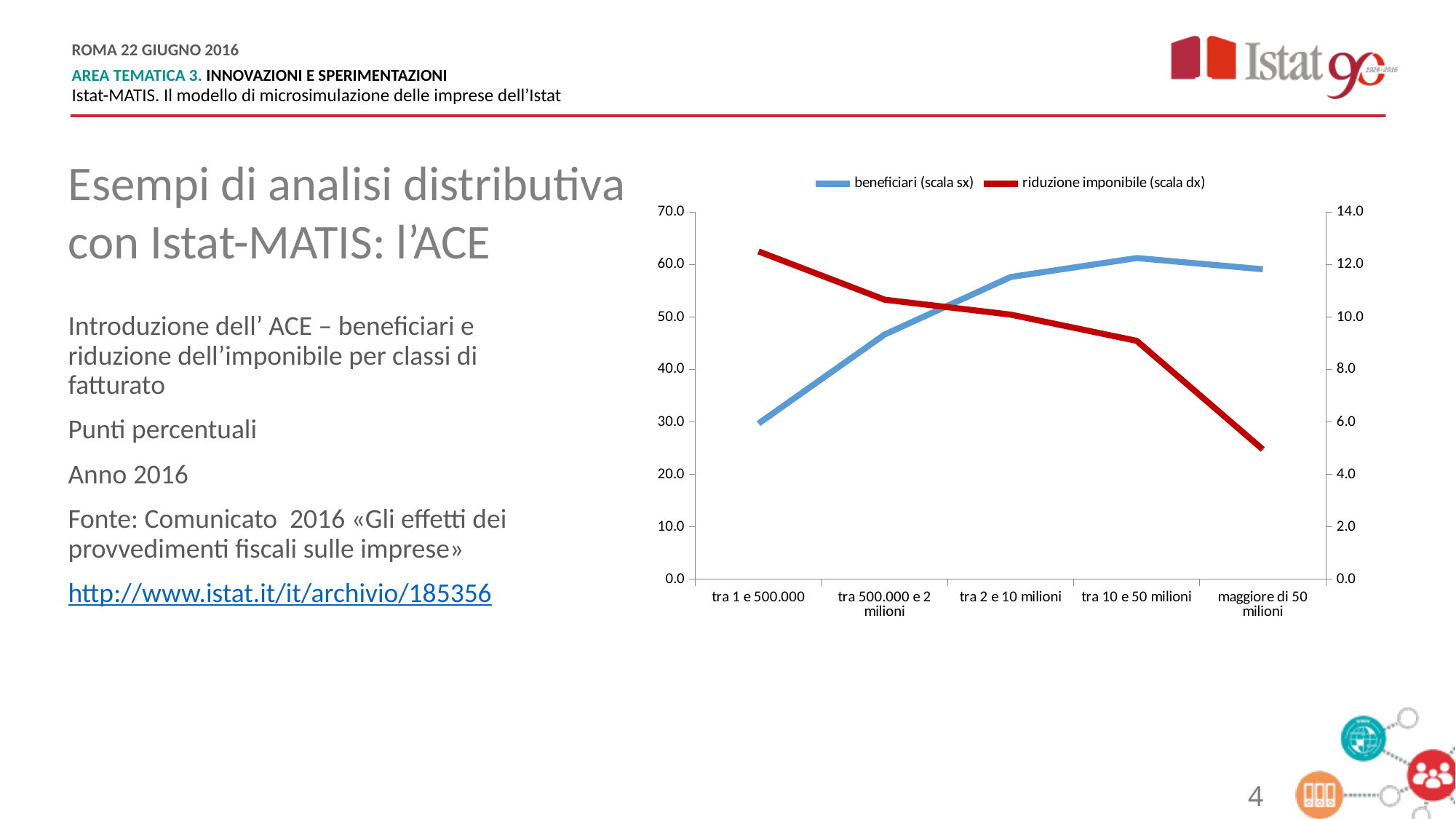
For which revenue class is the value of beneficiari highest? tra 10 e 50 milioni What colour is the line for beneficiari (scala sx)? blue How many series does the legend list? 2 For which revenue class is riduzione imponibile lowest? maggiore di 50 milioni Which series is plotted on the right-hand axis (scala dx)? riduzione imponibile Is the value of riduzione imponibile for 'maggiore di 50 milioni' greater or less than 6.0 on the right axis? less What kind of chart is shown on the slide? line chart Does the riduzione imponibile line rise or fall as you move from left to right along the x axis? fall Is the value of beneficiari for 'tra 2 e 10 milioni' greater or less than 50.0? greater For which revenue class is the value of beneficiari lowest? tra 1 e 500.000 How many revenue classes (categories) are shown on the x axis? 5 For which revenue class is riduzione imponibile highest? tra 1 e 500.000